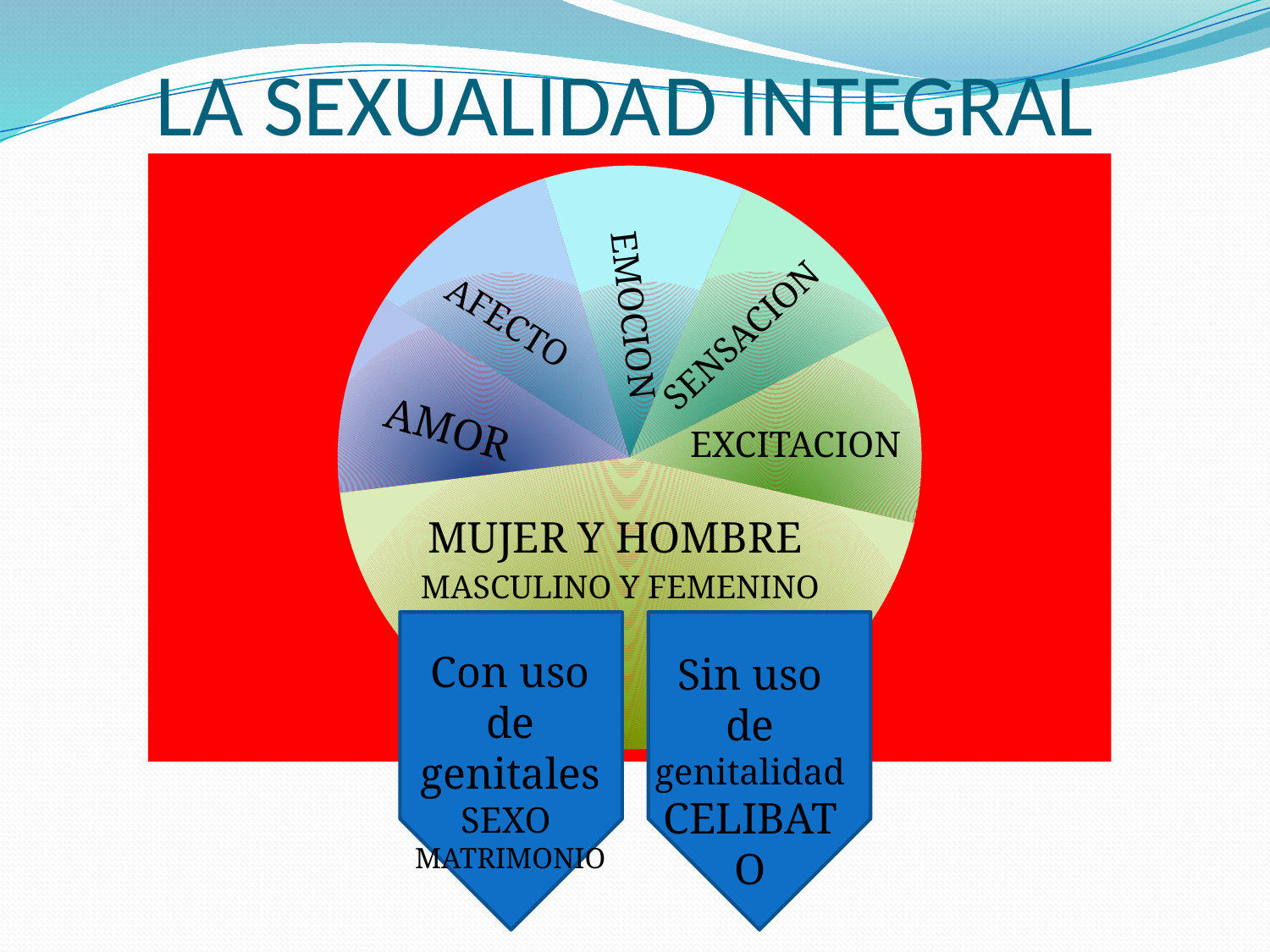
What kind of chart is shown on the slide? pie chart What subtitle text appears under MUJER Y HOMBRE in the largest segment of the pie chart? MASCULINO Y FEMENINO What is the title of the slide containing the pie chart? LA SEXUALIDAD INTEGRAL Which is larger in the pie chart, the MUJER Y HOMBRE segment or the EXCITACION segment? MUJER Y HOMBRE Which segment of the pie chart is the largest? MUJER Y HOMBRE Which is larger in the pie chart, the AMOR segment or the EMOCION segment? Neither; they are the same size How many labelled segments does the pie chart have? 6